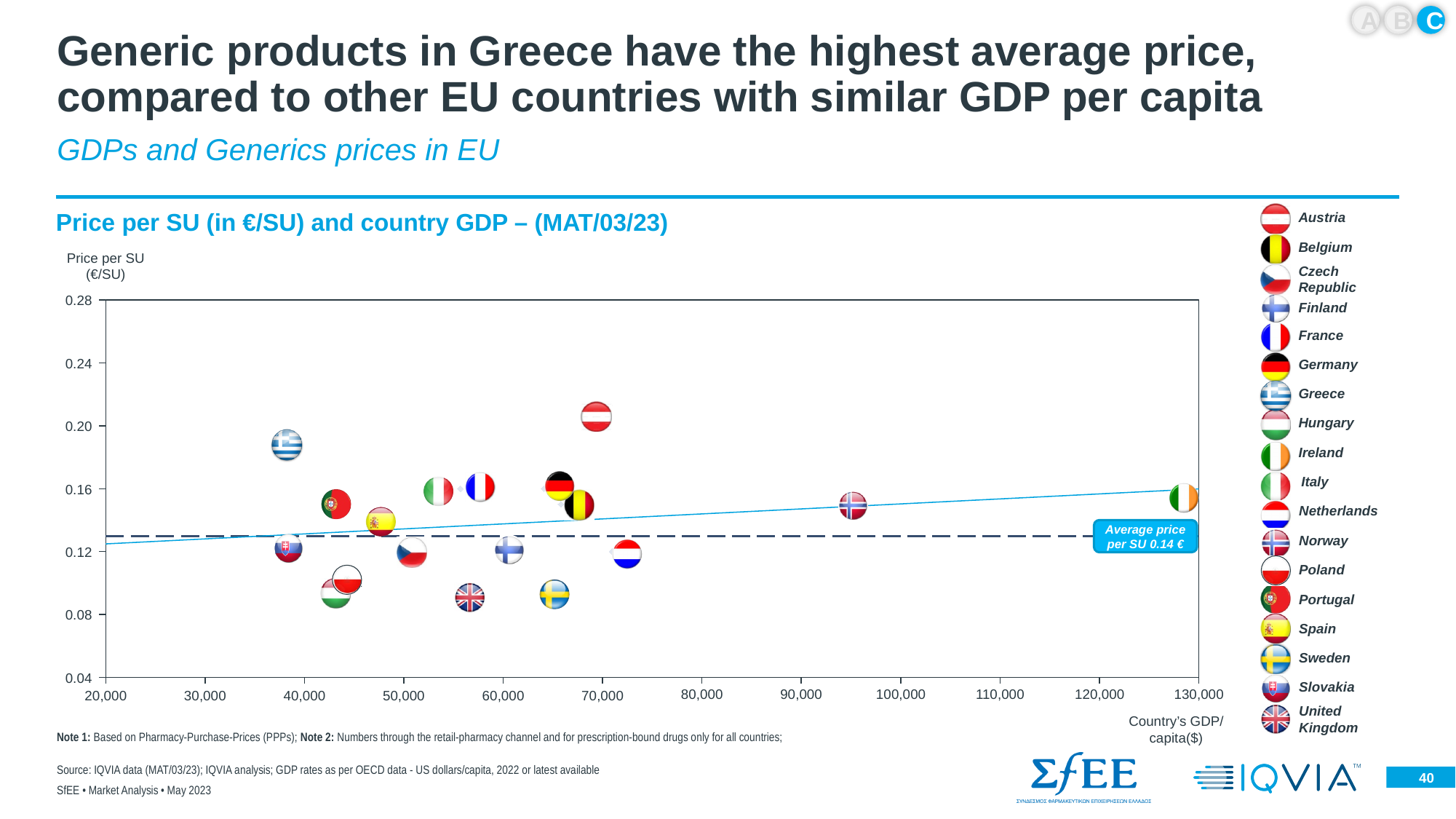
Which country has the highest GDP per capita in the chart? Ireland Is the price per SU for Poland greater or less than 0.12? less Is the GDP per capita for Ireland greater or less than 120,000? greater Is the GDP per capita for Norway greater or less than 90,000? greater Which has a higher price per SU, Greece or Spain? Greece Which country has the highest price per SU in the chart? Austria Which has a higher GDP per capita, Norway or Austria? Norway What kind of chart is shown on the slide? Scatter chart What is the average price per SU shown by the dashed line? 0.14 € How many countries are listed in the legend? 18 What is the label of the x axis? Country's GDP/capita($)